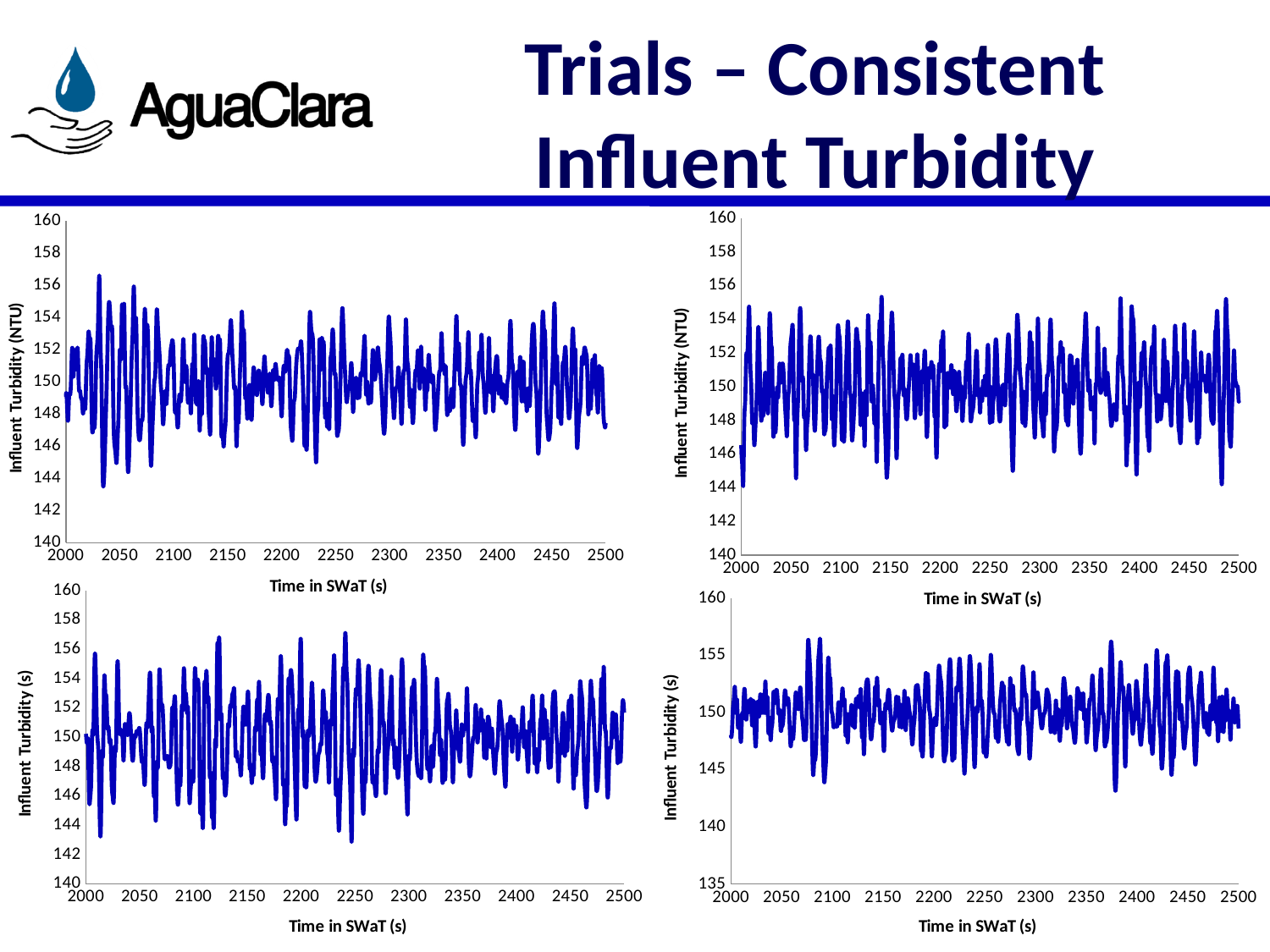
What is the lowest value shown on the y-axis of the bottom-right chart? 135 What kind of chart is the top-left chart on the slide? line chart In the top-left chart, is the lowest value of the line greater or less than 142? greater What is the y-axis label of the top-right chart? Influent Turbidity (NTU) In the top-right chart, is the highest value of the line greater or less than 158? less In the bottom-right chart, is the lowest value of the line greater or less than 140? greater Over the x-axis range from 2000 to 2500, does the line in the top-right chart show a clear rising trend, a clear falling trend, or fluctuate around a roughly constant level? fluctuate around a roughly constant level What is the x-axis label of the top-left chart? Time in SWaT (s) How many charts are shown on the slide? 4